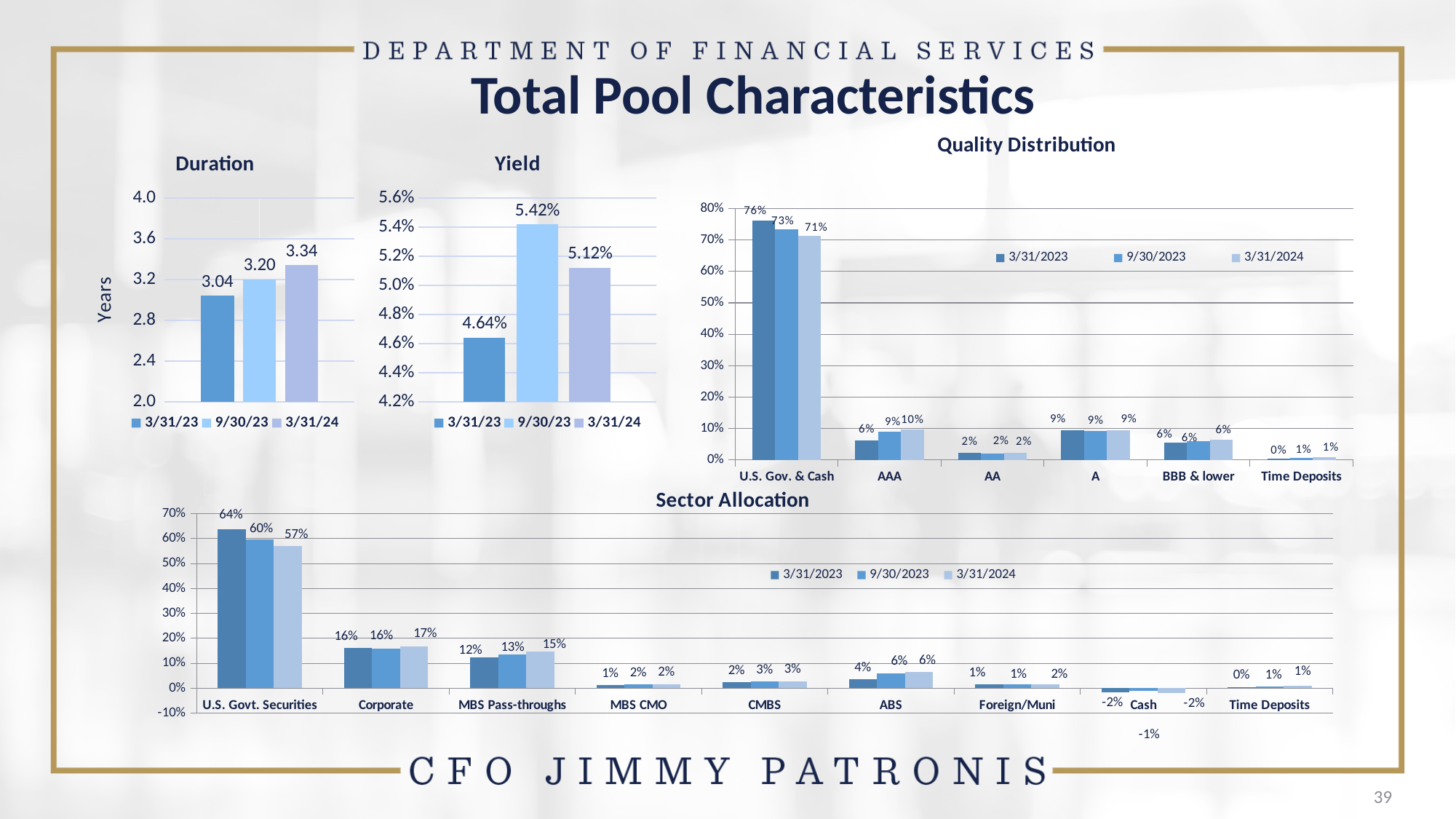
In the Sector Allocation chart, which category has the highest value for 3/31/2023? U.S. Govt. Securities In the Sector Allocation chart, what is the difference between the U.S. Govt. Securities values for 3/31/2023 and 3/31/2024? 7% In the Duration chart, what is the difference between the 3/31/24 and 3/31/23 durations? 0.30 In the Yield chart, which date has the lowest yield? 3/31/23 In the Quality Distribution chart, what is the value for AAA on 9/30/2023? 9% In the Sector Allocation chart, what is the value for MBS Pass-throughs on 3/31/2024? 15% In the Duration chart, what is the duration in years for 3/31/24? 3.34 In the Yield chart, what is the yield for 9/30/23? 5.42% In the Duration chart, do the values rise or fall from 3/31/23 to 3/31/24? rise In the Quality Distribution chart, what is the value for U.S. Gov. & Cash on 3/31/2024? 71% How many series does the legend of the Sector Allocation chart list? 3 In the Quality Distribution chart, how many categories are shown on the x axis? 6